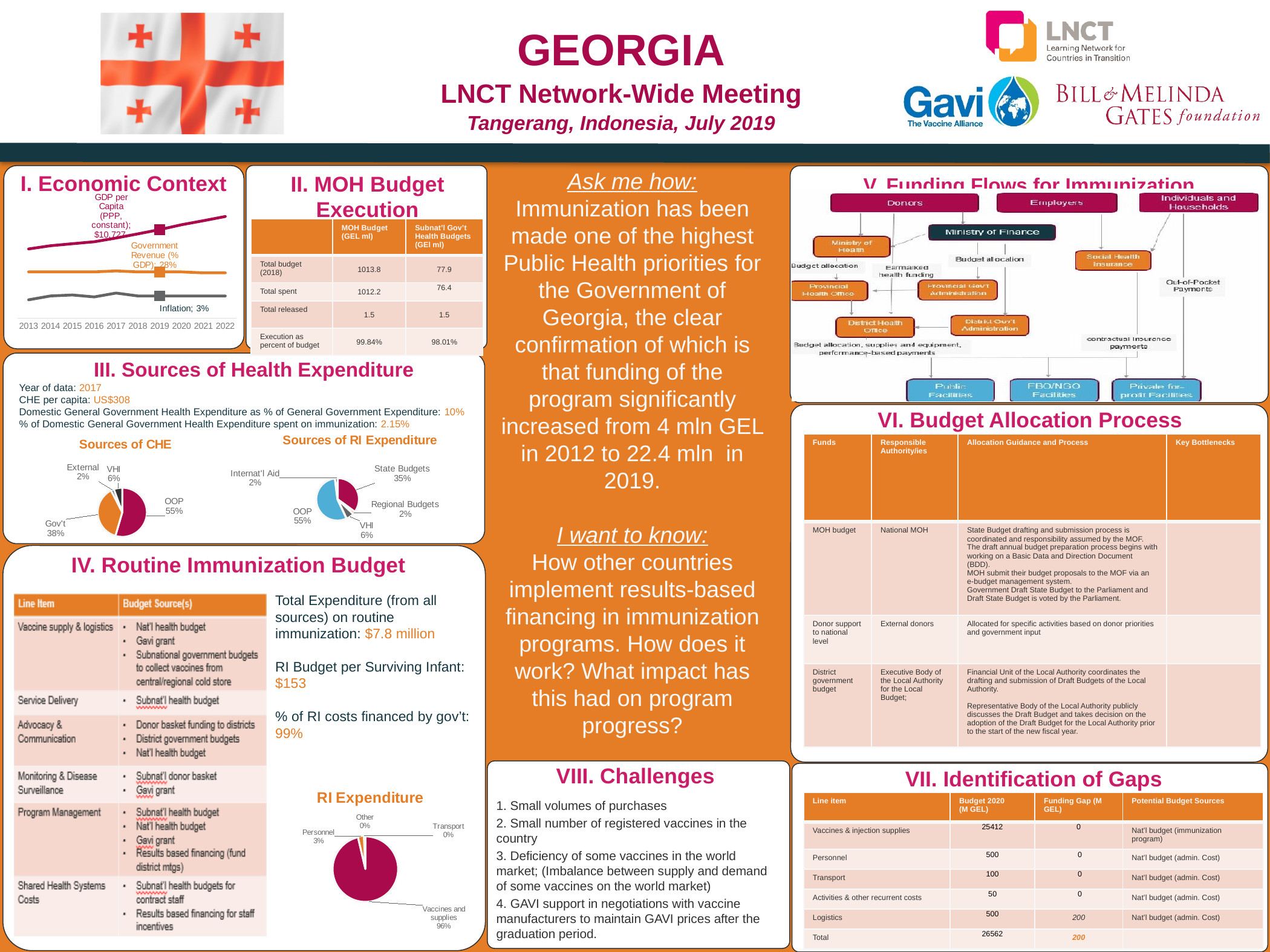
In the Sources of CHE pie chart, which source has the smallest share? External In the RI Expenditure pie chart, what share is Personnel? 3% In the Economic Context chart, what is the labelled value for Government Revenue (% GDP)? 28% In the Sources of RI Expenditure pie chart, which source has the largest share? OOP In the RI Expenditure pie chart, what share is Vaccines and supplies? 96% In the RI Expenditure pie chart, which is larger, Personnel or Vaccines and supplies? Vaccines and supplies In the Sources of CHE pie chart, what share is Gov't? 38% In the Sources of CHE pie chart, what is the difference between the OOP share and the Gov't share? 17% In the Sources of RI Expenditure pie chart, what share is State Budgets? 35% In the Sources of CHE pie chart, what share is OOP? 55% In the Sources of RI Expenditure pie chart, how many sources are shown? 5 In the Economic Context chart, what is the labelled value for Inflation? 3%